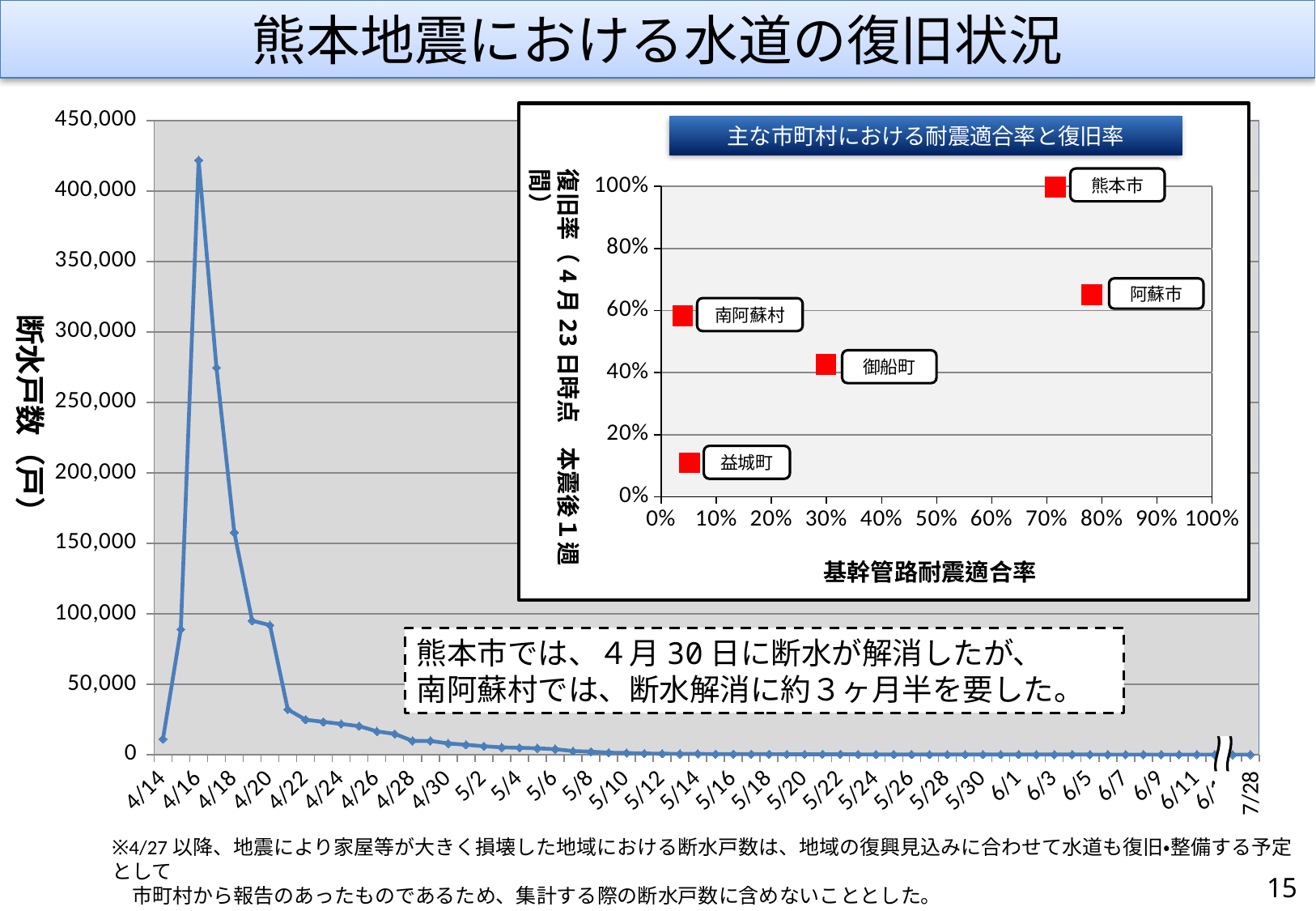
In the inset chart 主な市町村における耐震適合率と復旧率, which has the higher 復旧率, 南阿蘇村 or 御船町? 南阿蘇村 What kind of chart is the inset chart titled 主な市町村における耐震適合率と復旧率? scatter chart In the large line chart, does the 断水戸数 rise or fall from 4/16 onward? fall In the inset chart 主な市町村における耐震適合率と復旧率, how many municipalities are plotted? 5 In the inset chart 主な市町村における耐震適合率と復旧率, which municipality has the highest 復旧率? 熊本市 What kind of chart is the large chart on the left showing 断水戸数 over dates? line chart In the inset chart 主な市町村における耐震適合率と復旧率, which has the higher 基幹管路耐震適合率, 御船町 or 益城町? 御船町 What is the label on the vertical axis of the large line chart? 断水戸数（戸） In the large line chart, is the peak value of 断水戸数 on 4/16 greater or less than 400,000? greater In the inset chart 主な市町村における耐震適合率と復旧率, is the 復旧率 for 御船町 greater or less than 50%? less In the inset chart 主な市町村における耐震適合率と復旧率, which municipality has the lowest 復旧率? 益城町 In the inset chart 主な市町村における耐震適合率と復旧率, is the 復旧率 for 益城町 greater or less than 20%? less